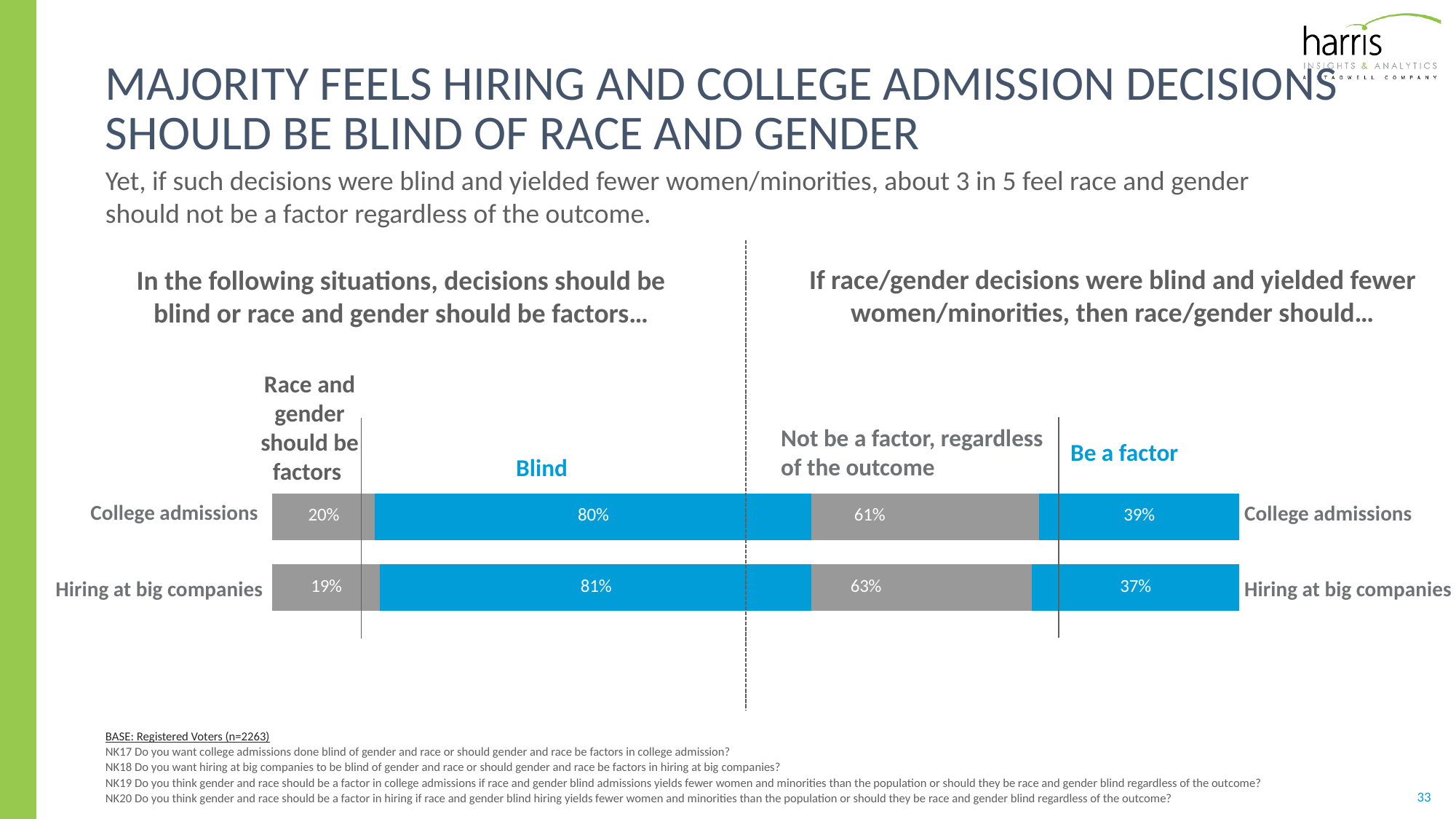
In the right chart, which category has the higher 'Be a factor' percentage? College admissions In the left chart, what is the difference between the 'Blind' percentage and the 'Race and gender should be factors' percentage for college admissions? 60% In the right chart (if race/gender decisions were blind and yielded fewer women/minorities), what percentage say race/gender should not be a factor regardless of the outcome for hiring at big companies? 63% In the left chart, which category has the higher 'Blind' percentage, college admissions or hiring at big companies? Hiring at big companies In the right chart, what is the difference between the 'Not be a factor, regardless of the outcome' percentages for hiring at big companies and college admissions? 2% In the left chart (decisions should be blind or race and gender should be factors), what percentage say race and gender should be factors in hiring at big companies? 19% In the right chart (if race/gender decisions were blind and yielded fewer women/minorities), what percentage say race/gender should be a factor for college admissions? 39% In the left chart, what is the total of the two segments for the hiring at big companies bar? 100% In the right chart, what colour are the 'Be a factor' segments? Blue What type of chart is used on the left side of the slide? Stacked bar chart How many categories are shown in the right chart? 2 In the left chart (decisions should be blind or race and gender should be factors), what percentage say college admissions should be blind? 80%